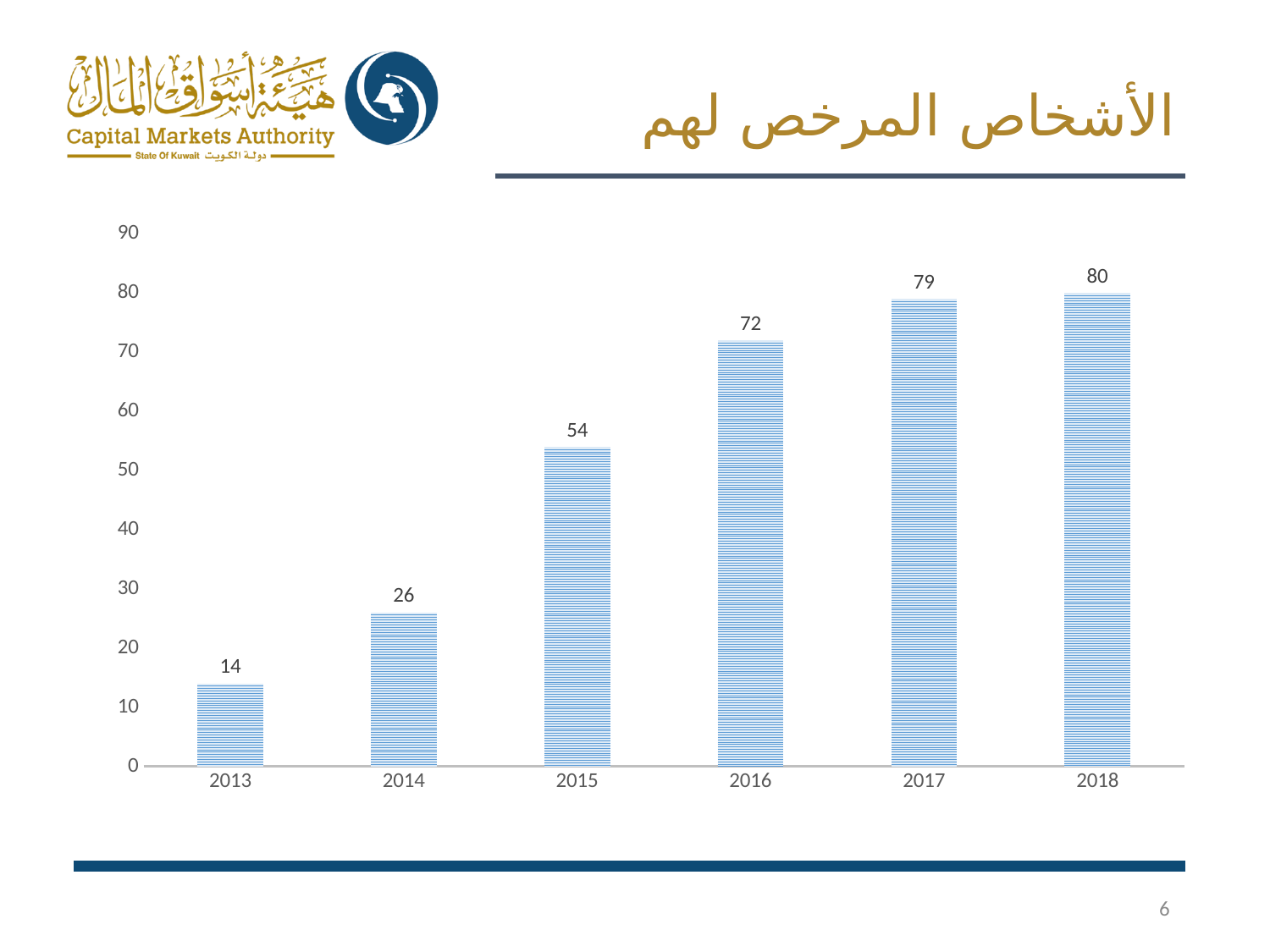
Which is larger, the value for 2015 or the value for 2016? 2016 What is the value for 2016? 72 What is the value for 2018? 80 Is the value for 2017 greater or less than 70? greater How many years are shown on the x axis? 6 Which year has the lowest value? 2013 What is the difference between the values for 2018 and 2013? 66 Do the values rise or fall from 2013 to 2018? rise Which year has the highest value? 2018 What kind of chart is shown on the slide? bar chart What is the difference between the values for 2015 and 2014? 28 What is the value for 2013? 14